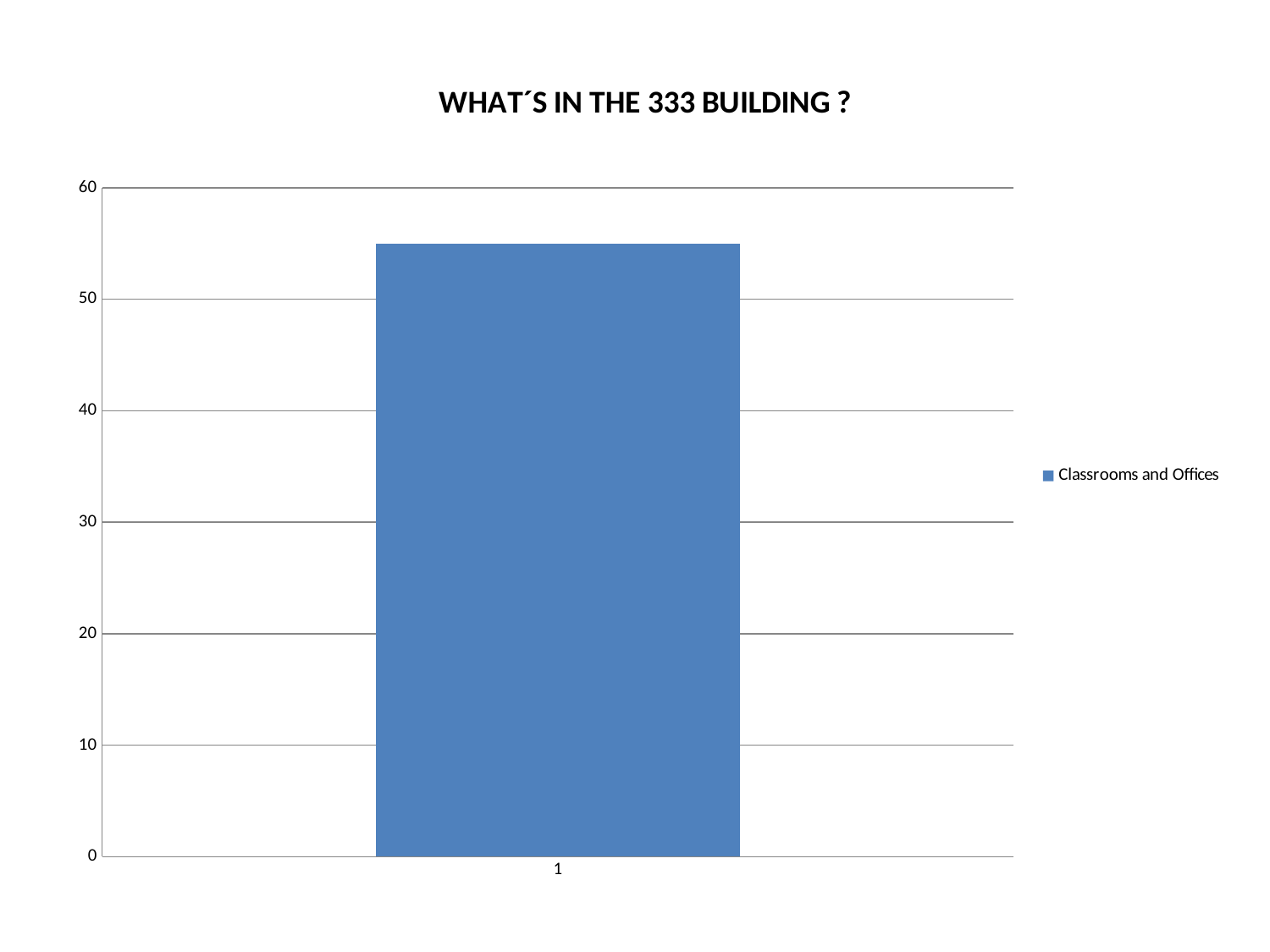
Is the value for Classrooms and Offices greater or less than 50? greater Is the value for category 1 greater or less than 40? greater Is the value for Classrooms and Offices greater or less than 60? less How many bars are plotted in the chart? 1 What is the highest value shown on the vertical axis? 60 What is the title of the chart? WHAT´S IN THE 333 BUILDING ? How many series does the legend list? 1 What series name is shown in the legend? Classrooms and Offices What kind of chart is shown on the slide? bar chart